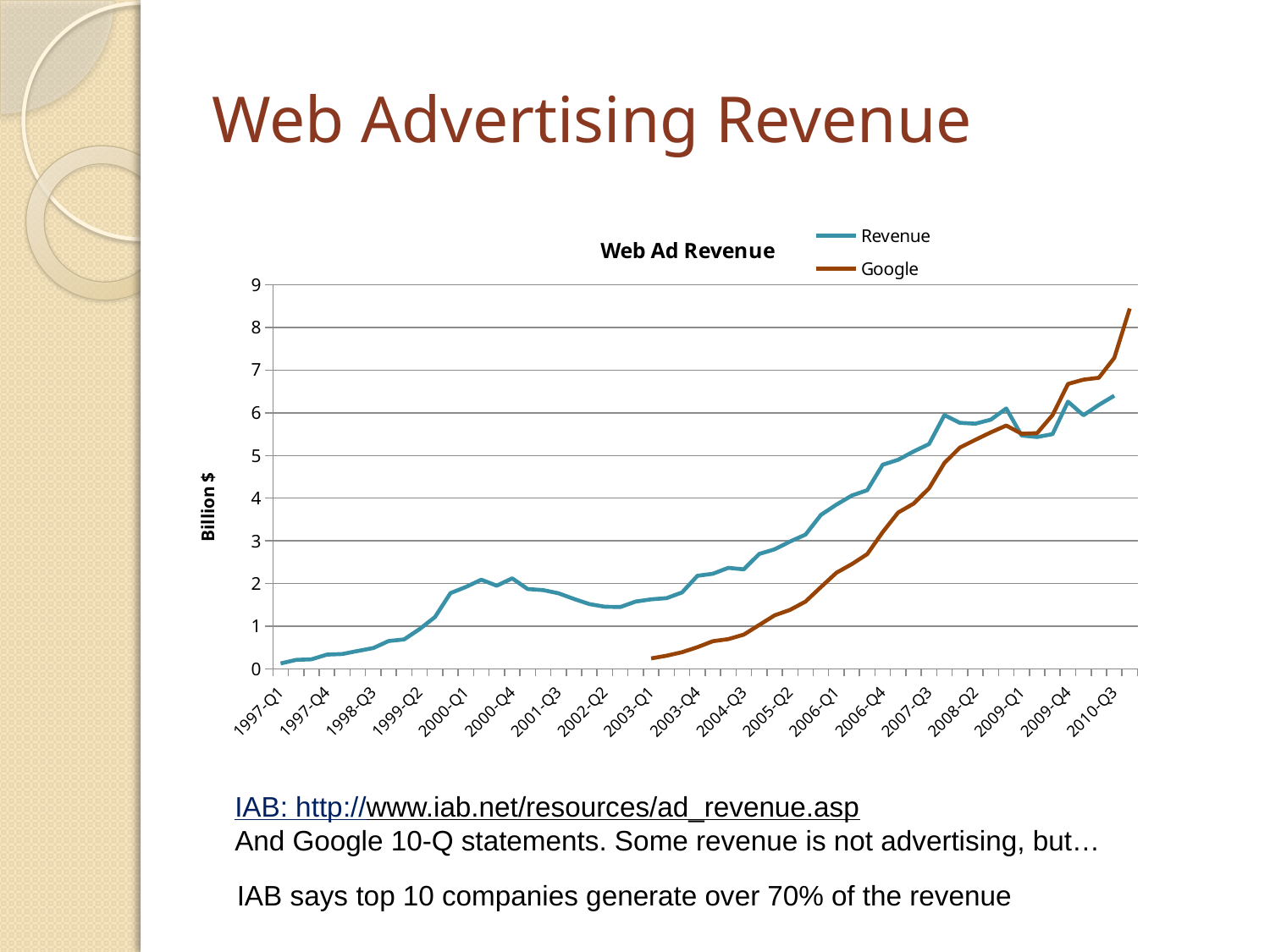
At the right end of the chart (2010-Q3), which series has the larger value, Revenue or Google? Google Is the Google value at 2006-Q1 greater or less than 3? less How many series does the legend of the chart list? 2 Is the Revenue value at 2008-Q2 greater or less than 5? greater Overall, does the Revenue line rise or fall from 1997-Q1 to 2010-Q3? rise Is the Google value at 2003-Q1 greater or less than 1? less What is the title of the chart? Web Ad Revenue What kind of chart is shown on the slide? line chart What is the label on the vertical axis of the chart? Billion $ At 2005-Q2, which series has the larger value, Revenue or Google? Revenue